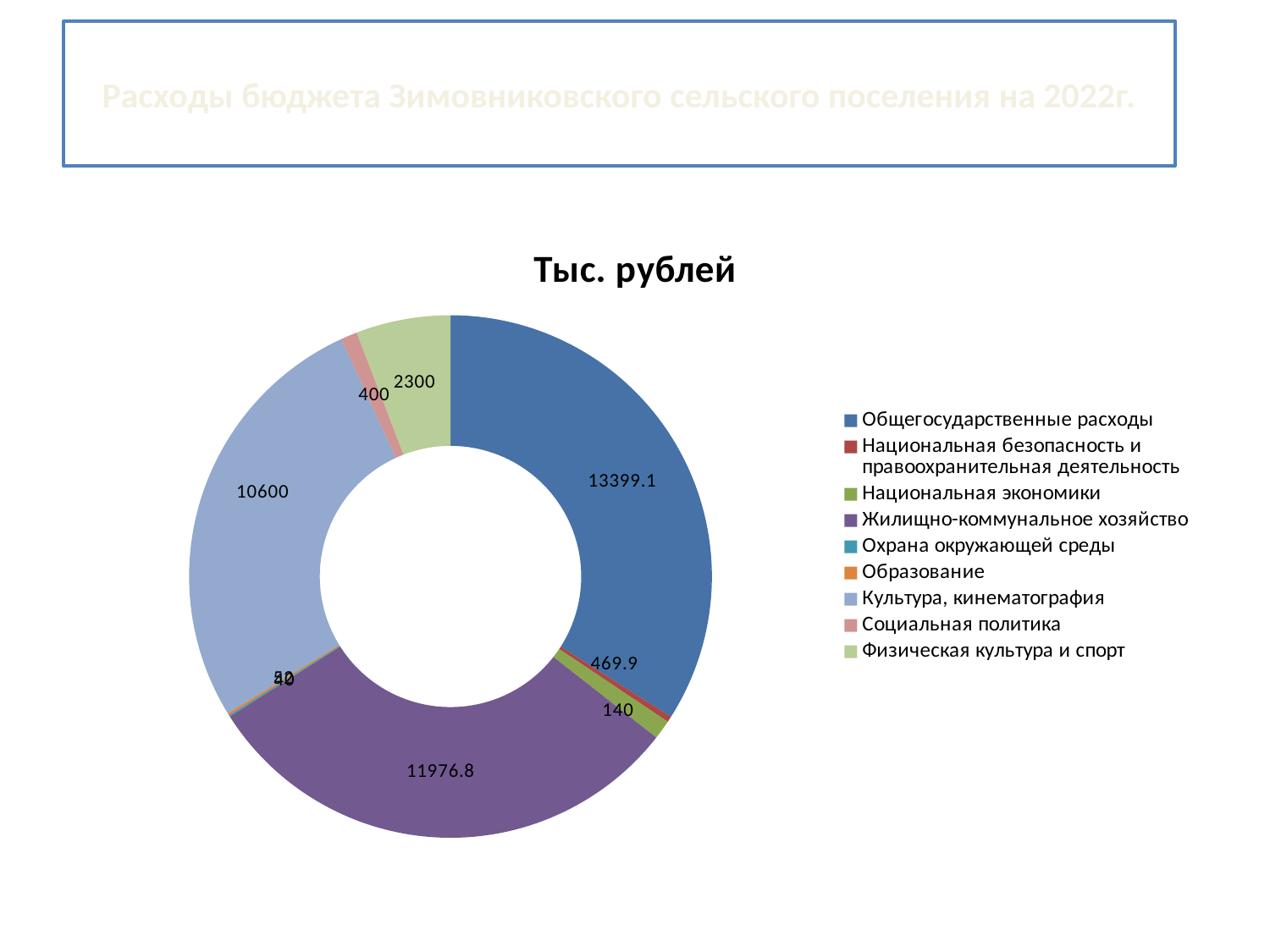
Which category has the largest value? Общегосударственные расходы What is the value for Социальная политика? 400 What is the title of the chart? Тыс. рублей What is the difference between Общегосударственные расходы and Жилищно-коммунальное хозяйство? 1422.3 What is the value for Жилищно-коммунальное хозяйство? 11976.8 How many categories does the legend list? 9 What is the value for Культура, кинематография? 10600 What is the value for Общегосударственные расходы? 13399.1 What kind of chart is shown on the slide? Doughnut (pie) chart What is the value for Национальная безопасность и правоохранительная деятельность? 140 Which is larger: Культура, кинематография or Жилищно-коммунальное хозяйство? Жилищно-коммунальное хозяйство What is the value for Физическая культура и спорт? 2300